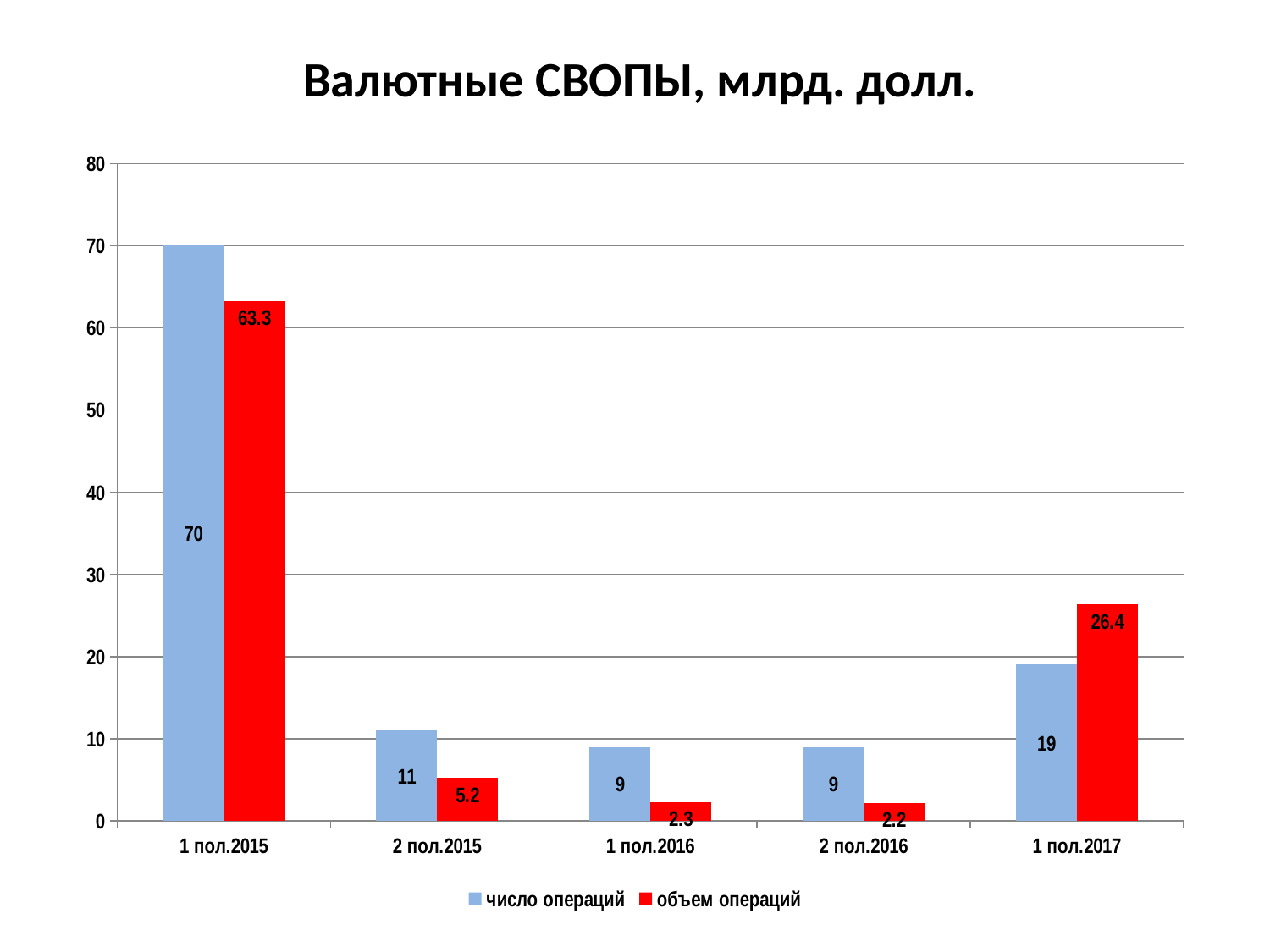
What is the value of объем операций for 2 пол.2016? 2.2 What is the value of число операций for 1 пол.2015? 70 What is the difference between объем операций for 1 пол.2017 and 2 пол.2015? 21.2 How many periods are shown on the x axis? 5 Which period has the lowest value of объем операций? 2 пол.2016 For 1 пол.2017, which is larger: число операций or объем операций? объем операций What is the title of the chart? Валютные СВОПЫ, млрд. долл. What kind of chart is shown on the slide? bar chart What is the difference between число операций for 1 пол.2015 and 1 пол.2017? 51 What is the value of объем операций for 1 пол.2017? 26.4 Which period has the highest value of объем операций? 1 пол.2015 How many series does the legend list? 2